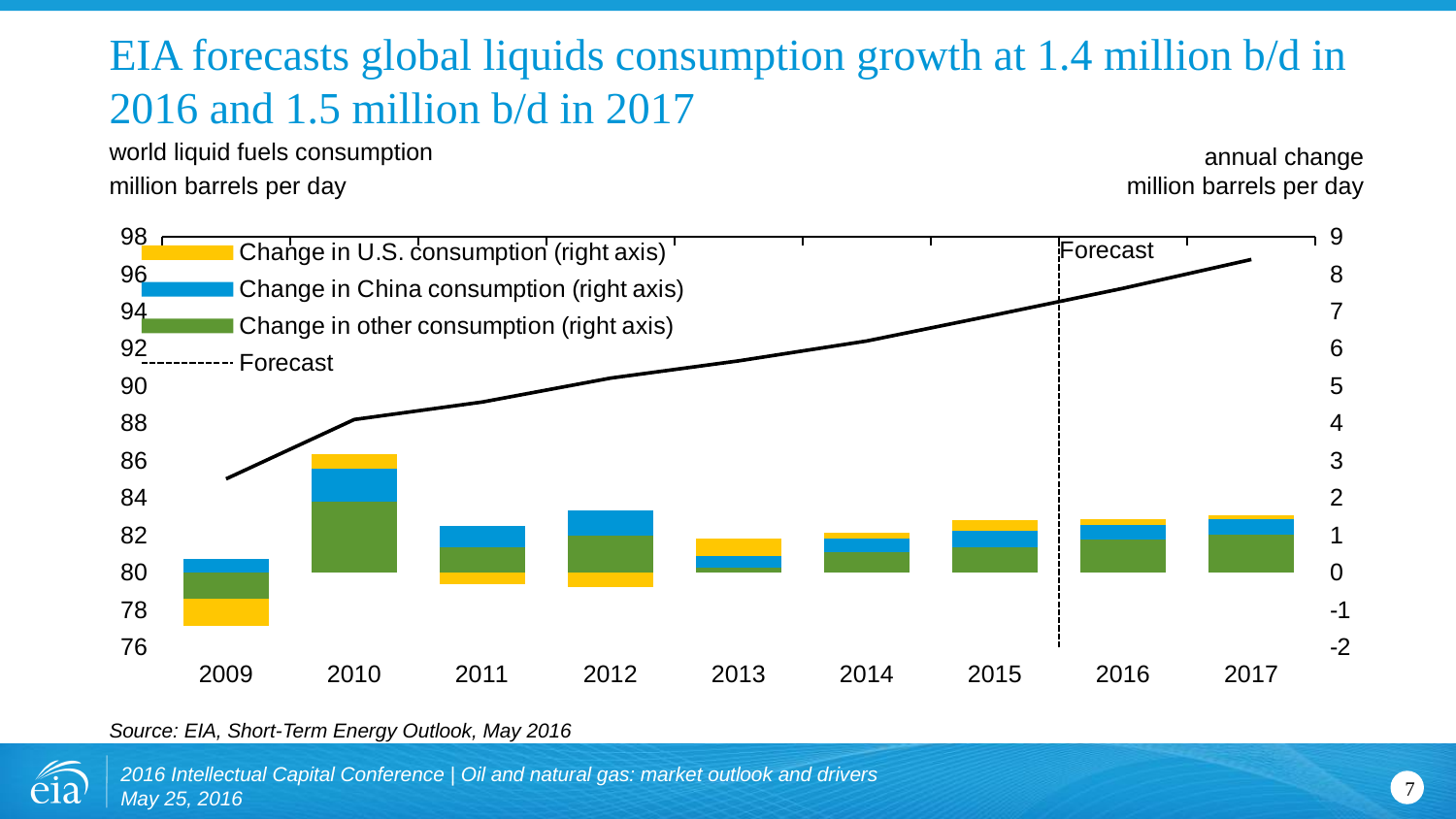
Which year shows the lowest world liquid fuels consumption on the line? 2009 Is world liquid fuels consumption in 2009 greater or less than 86 million barrels per day? less Which years on the chart fall in the forecast period? 2016 and 2017 Is world liquid fuels consumption in 2017 greater or less than 94 million barrels per day? greater According to the slide title, what is EIA's forecast for global liquids consumption growth in 2016? 1.4 million b/d How many entries does the chart legend list? 4 Which year has the larger total annual change in consumption, 2010 or 2011? 2010 Does world liquid fuels consumption rise or fall from 2009 to 2017? Rises How many years are shown along the x axis of the chart? 9 Is the total annual change in consumption for 2010 greater or less than 2 million barrels per day? greater What kind of chart is shown on the slide? A combination of a stacked bar chart and a line chart Which year has the largest total annual change in consumption (tallest stacked bar)? 2010